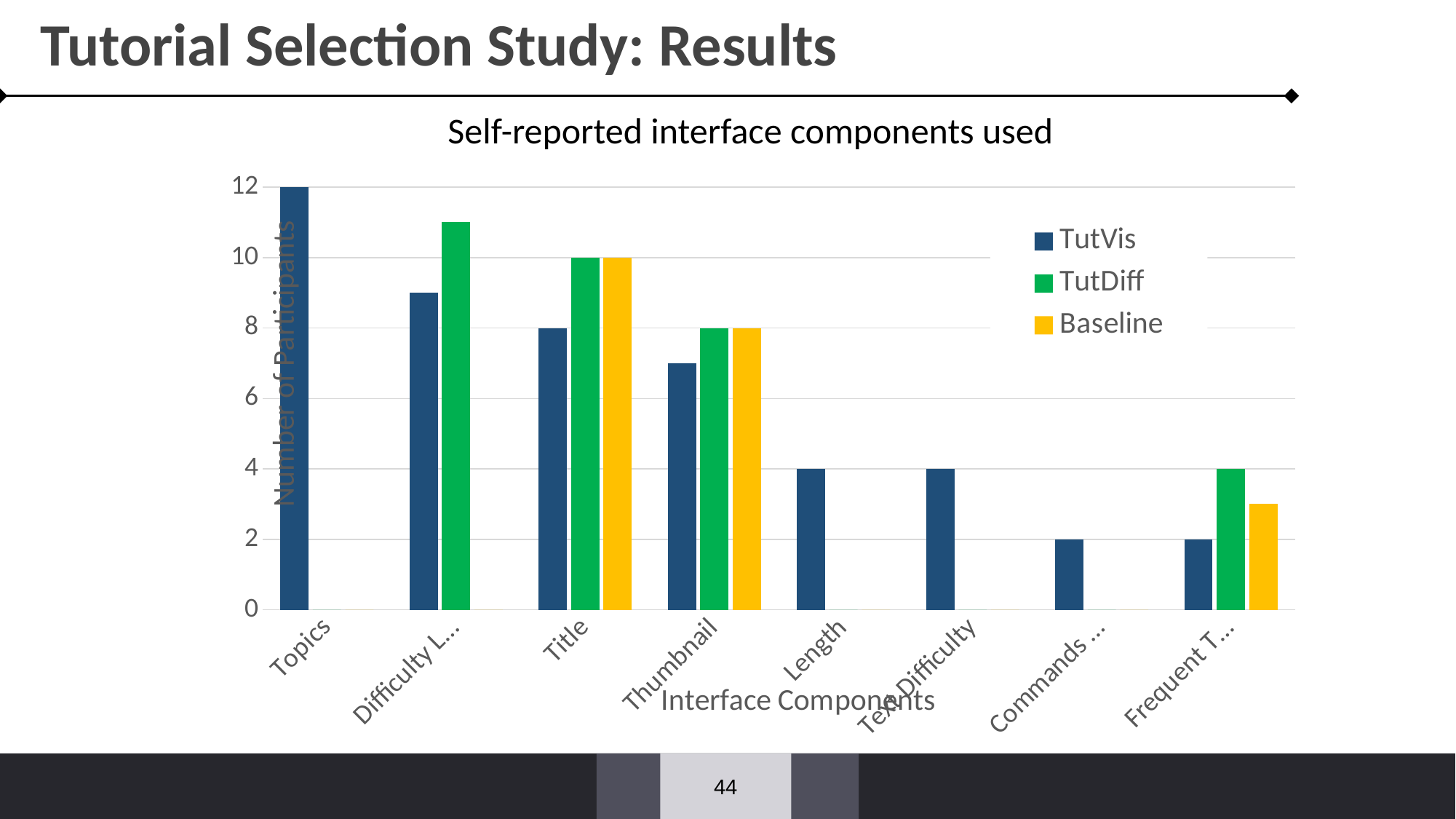
Is the TutVis value for Difficulty L... greater or less than 8? greater Is the Baseline value for Frequent T... greater or less than 2? greater Which category has the highest TutVis value? Topics How many categories are shown on the x axis? 8 For Title, which series has the larger value, TutVis or TutDiff? TutDiff What is the TutDiff value for Title? 10 What kind of chart is shown on the slide? bar chart What is the TutVis value for Commands ...? 2 How many series does the legend list? 3 What is the TutVis value for Topics? 12 What is the difference between the TutDiff and TutVis values for Title? 2 What is the TutVis value for Length? 4